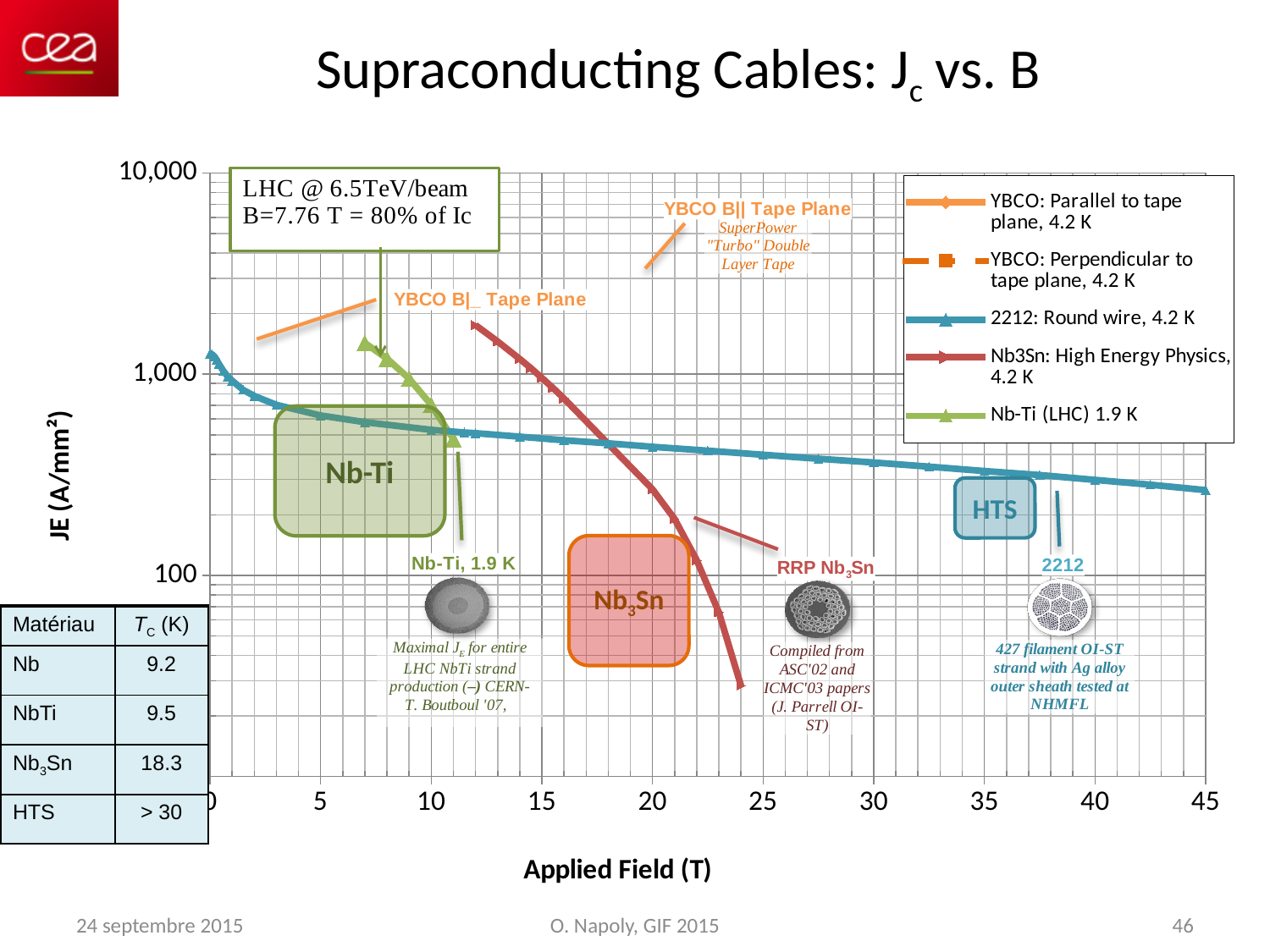
Is the value of the 2212: Round wire, 4.2 K series at 0 T greater or less than 1,000? greater How many series does the chart legend list? 5 Does the 2212: Round wire, 4.2 K series rise or fall as the applied field increases? fall What kind of chart is shown on the slide? line chart What is the label of the y axis of the chart? JE (A/mm²) Is the value of the 2212: Round wire, 4.2 K series at 45 T greater or less than 1,000? less Is the value of the Nb3Sn: High Energy Physics, 4.2 K series at 24 T greater or less than 100? less At 20 T, which series has the larger value: 2212: Round wire, 4.2 K or Nb3Sn: High Energy Physics, 4.2 K? 2212: Round wire, 4.2 K Which series extends to the highest applied field on the chart? 2212: Round wire, 4.2 K What is the highest value labelled on the x axis of the chart? 45 What is the label of the x axis of the chart? Applied Field (T)